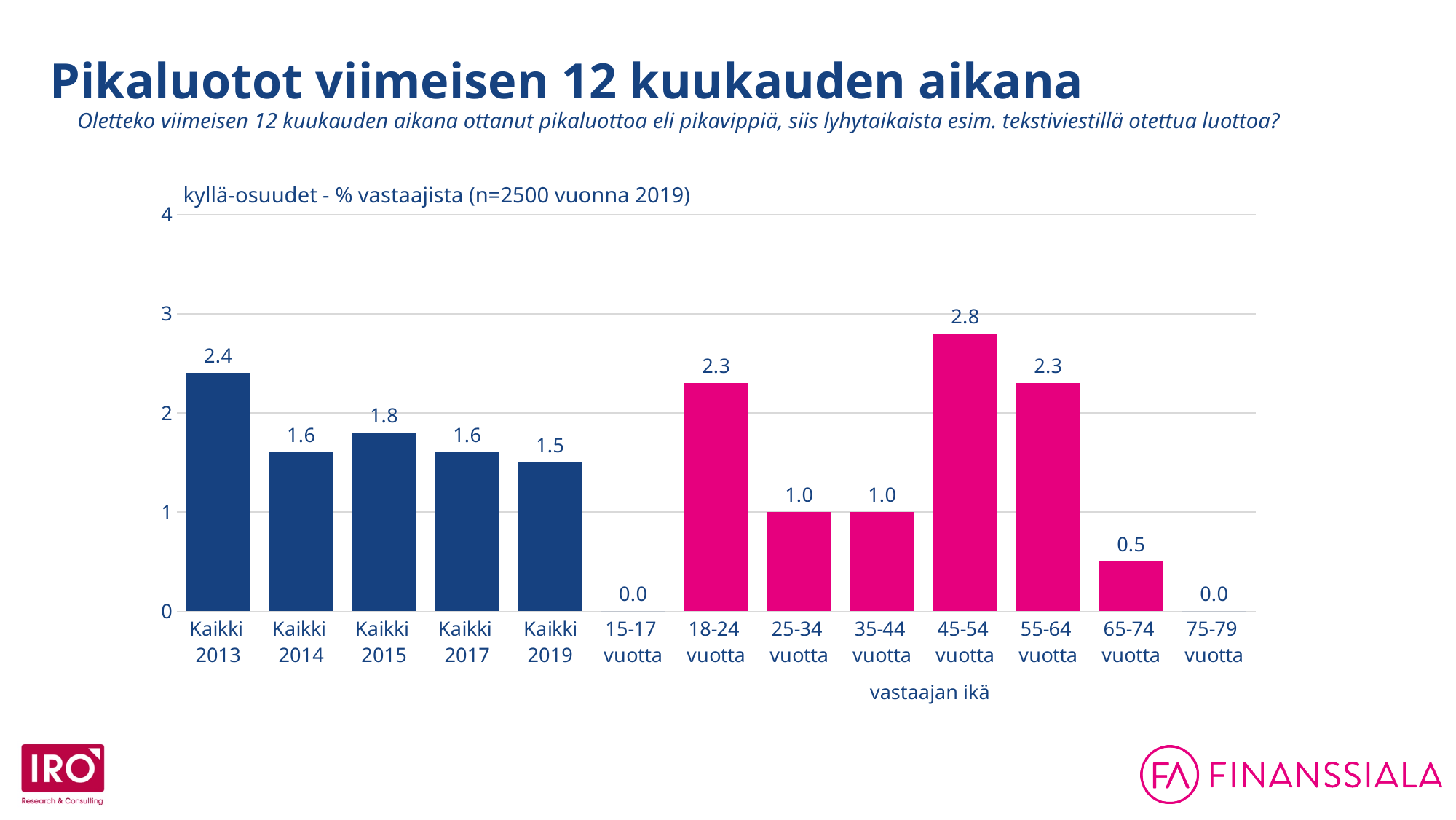
How many categories have a value of 0.0? 2 What kind of chart is shown on the slide? Bar chart What is the difference between the values for Kaikki 2013 and Kaikki 2019? 0.9 What is the value for the 65-74 vuotta age group? 0.5 Which age group has the highest value among the age groups? 45-54 vuotta Which is larger, the value for 18-24 vuotta or the value for 25-34 vuotta? 18-24 vuotta Which category has the highest value? 45-54 vuotta What is the x-axis label under the age group bars? vastaajan ikä What is the value for Kaikki 2019? 1.5 What is the value for Kaikki 2013? 2.4 What is the value for the 45-54 vuotta age group? 2.8 How many categories are shown on the x axis? 13